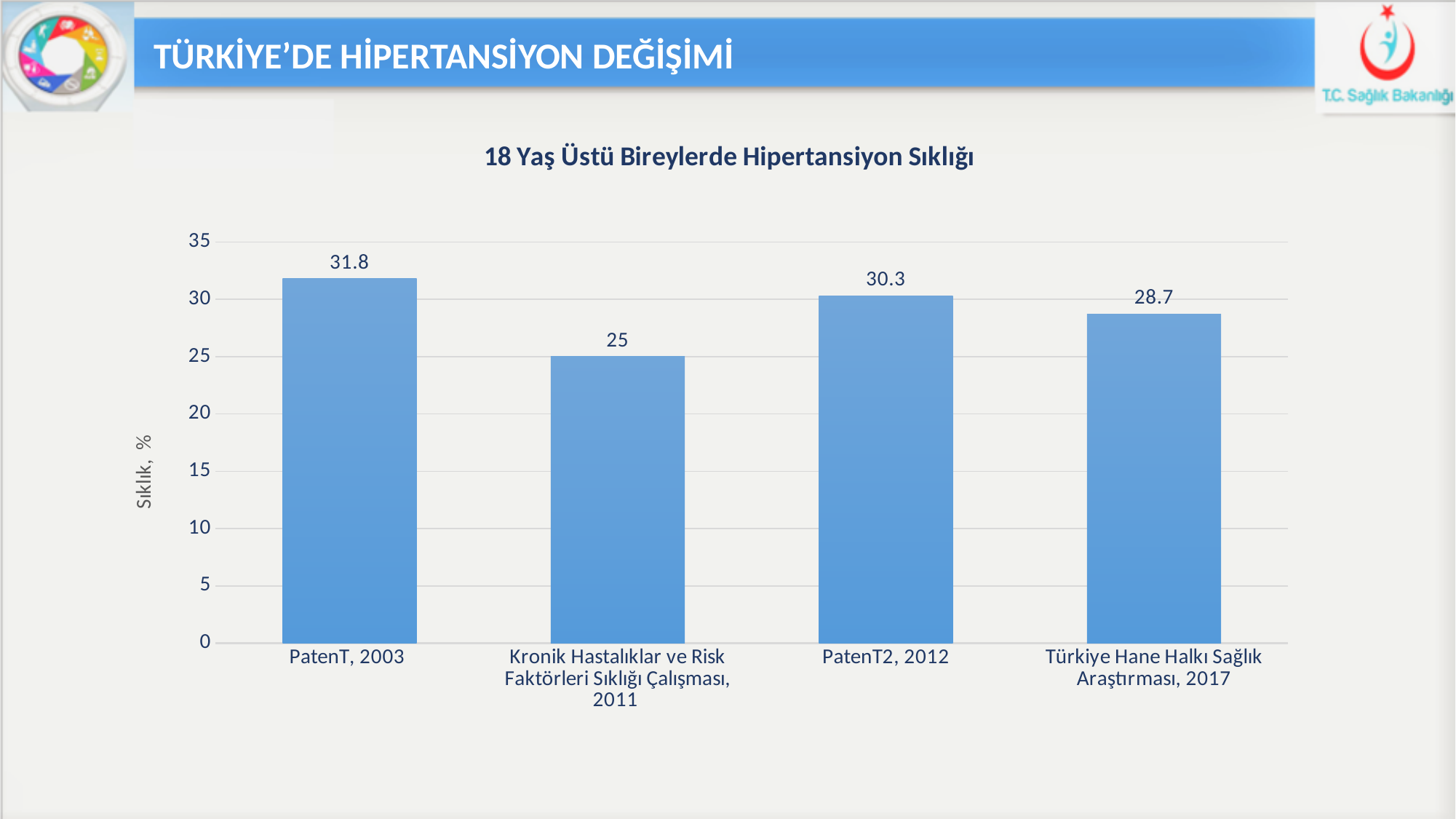
Which category has the lowest value? Kronik Hastalıklar ve Risk Faktörleri Sıklığı Çalışması, 2011 What is the value for Türkiye Hane Halkı Sağlık Araştırması, 2017? 28.7 How many categories are shown in the chart? 4 What is the value for PatenT2, 2012? 30.3 What is the title of the chart? 18 Yaş Üstü Bireylerde Hipertansiyon Sıklığı What is the value for Kronik Hastalıklar ve Risk Faktörleri Sıklığı Çalışması, 2011? 25 What is the difference between the values for PatenT, 2003 and Türkiye Hane Halkı Sağlık Araştırması, 2017? 3.1 What is the value for PatenT, 2003? 31.8 Is the value for PatenT2, 2012 greater or less than 30? greater What kind of chart is shown on the slide? bar chart Which category has the highest value? PatenT, 2003 Which is larger, the value for PatenT2, 2012 or the value for Türkiye Hane Halkı Sağlık Araştırması, 2017? PatenT2, 2012